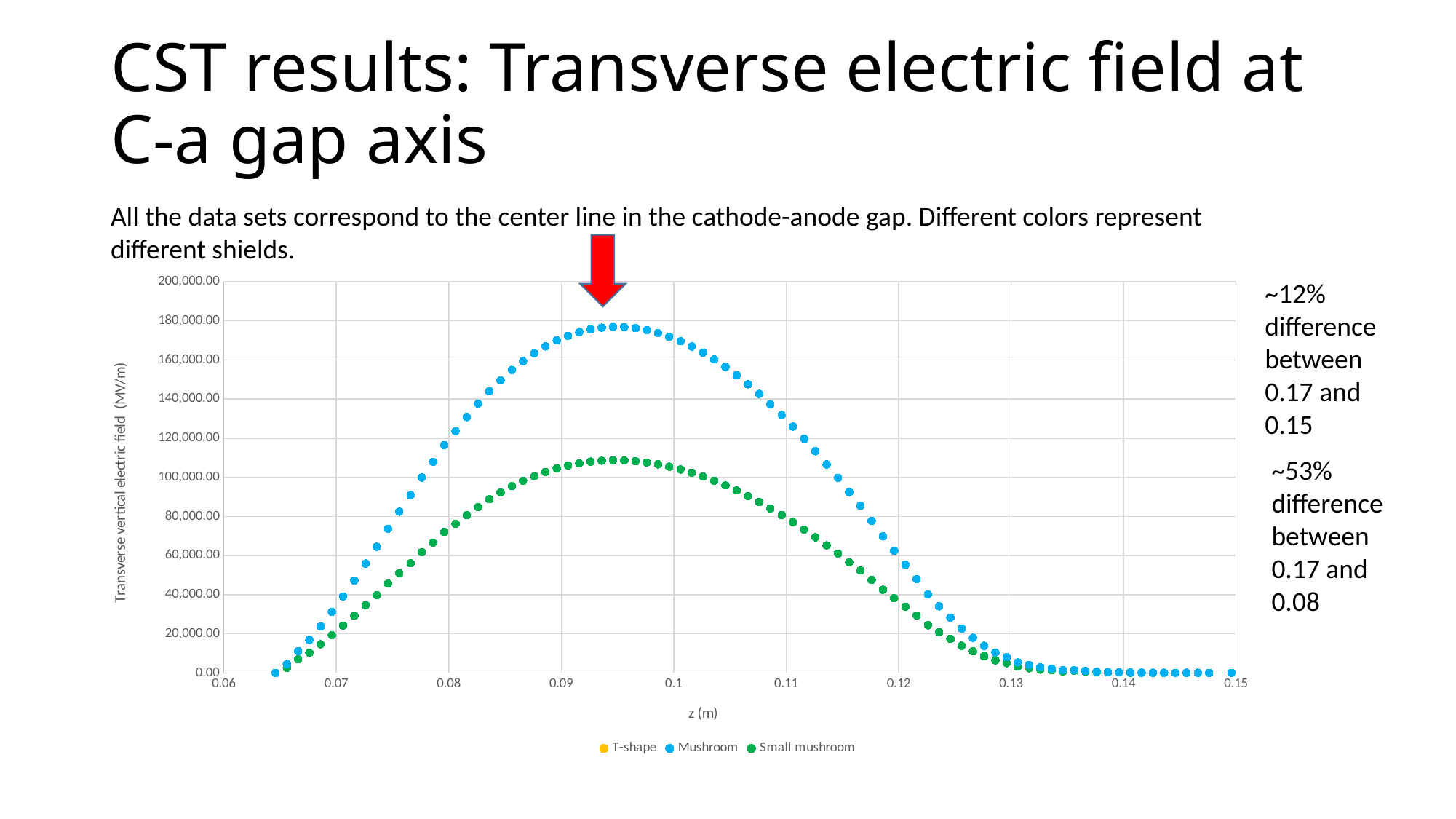
How do the Mushroom series values change as z increases from 0.1 to 0.14? they fall Which series reaches the higher peak value, Mushroom or Small mushroom? Mushroom How many series does the chart legend list? 3 Between which two x-axis ticks does the Mushroom series reach its maximum? 0.09 and 0.1 Is the peak value of the Mushroom series greater or less than 160,000.00? greater Is the peak value of the Small mushroom series greater or less than 120,000.00? less What kind of chart is shown on the slide? scatter chart What are the series names listed in the chart legend? T-shape, Mushroom, Small mushroom Is the value of the Small mushroom series at z = 0.13 greater or less than 20,000.00? less What is the label of the x axis of the chart? z (m)